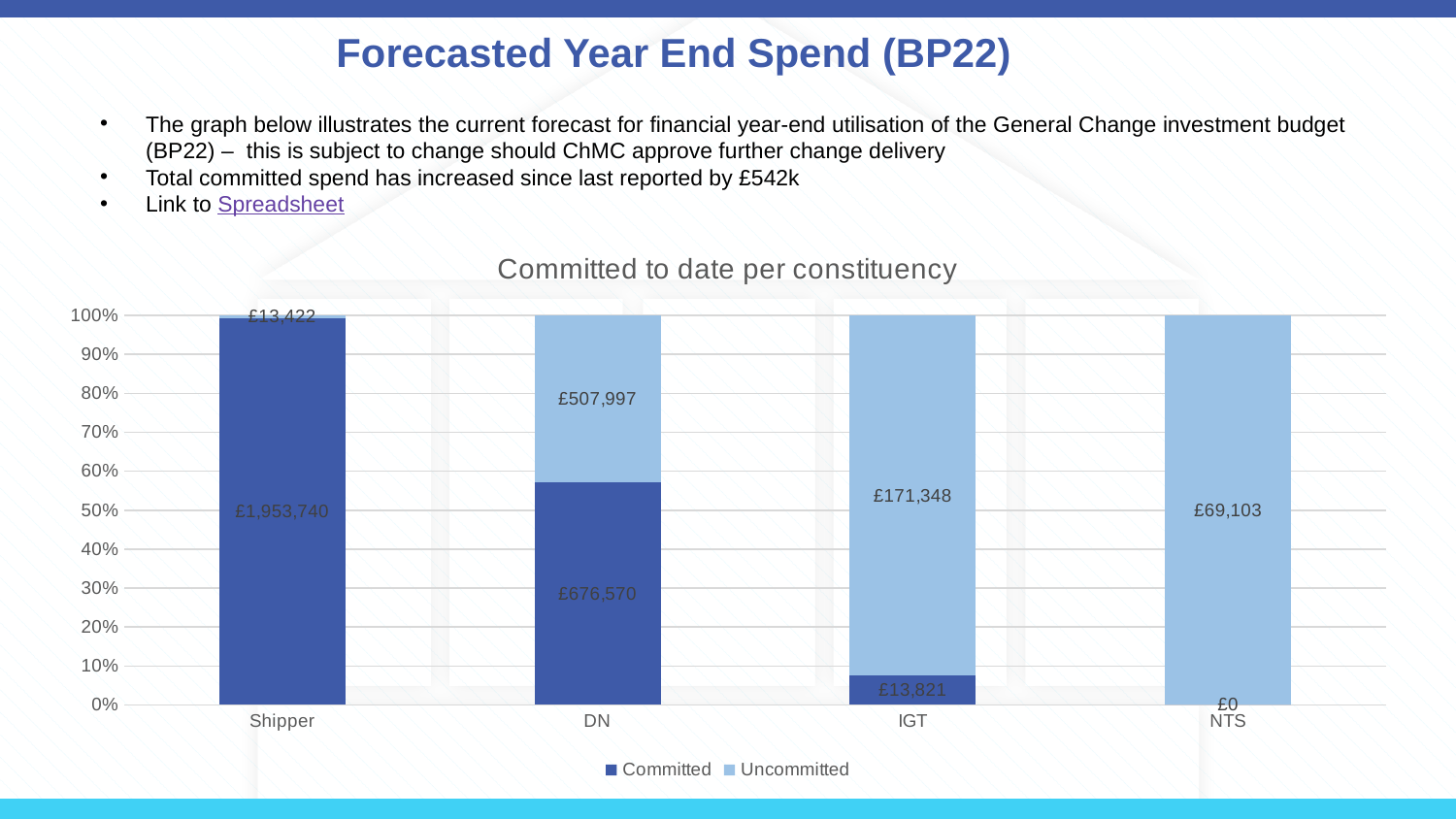
How many constituencies are shown on the x axis? 4 What is the Uncommitted value for DN? £507,997 Is the Committed share of the DN bar greater or less than 50%? greater Which constituency has the highest Committed value? Shipper What is the difference between the Committed and Uncommitted values for DN? £168,573 Which is larger for IGT, the Committed value or the Uncommitted value? Uncommitted How many series does the legend list? 2 What is the Committed value for Shipper? £1,953,740 What is the Uncommitted value for NTS? £69,103 What is the total of the Committed and Uncommitted values for IGT? £185,169 What is the Committed value for IGT? £13,821 Which constituency has the lowest Committed value? NTS